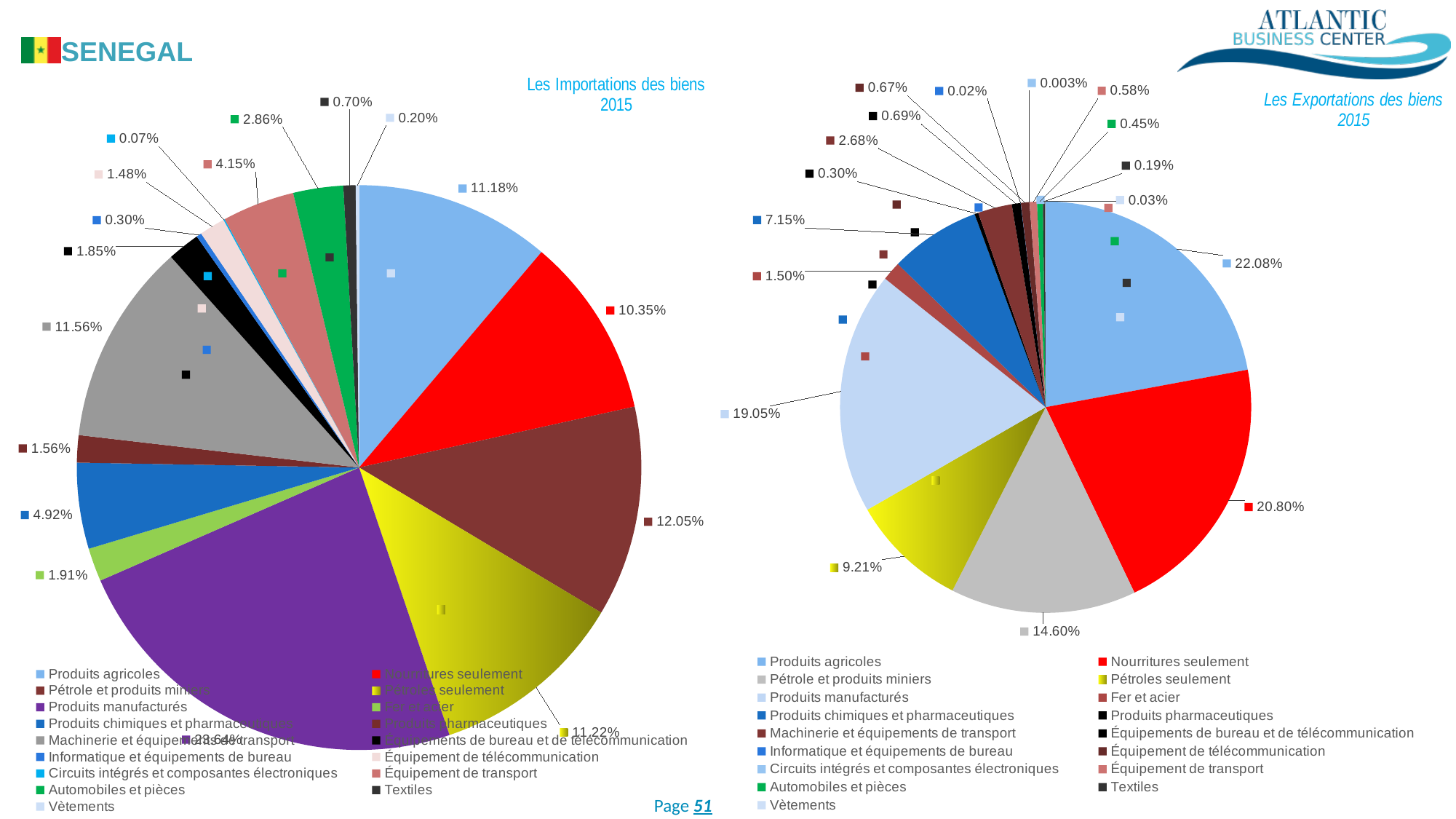
In the 'Les Importations des biens 2015' chart, what is the share for Automobiles et pièces? 2.86% In the 'Les Exportations des biens 2015' chart, what is the difference between the shares of Produits agricoles and Nourritures seulement? 1.28% How many categories does the legend of the 'Les Exportations des biens 2015' chart list? 17 In the 'Les Exportations des biens 2015' chart, what is the share for Produits manufacturés? 19.05% What kind of charts are shown on the slide? Pie charts In the 'Les Exportations des biens 2015' chart, which category has the largest slice? Produits agricoles In the 'Les Exportations des biens 2015' chart, what is the share for Pétrole et produits miniers? 14.60% In the 'Les Importations des biens 2015' chart, what is the share for Nourritures seulement? 10.35% In the 'Les Importations des biens 2015' chart, what is the share for Produits agricoles? 11.18% In the 'Les Importations des biens 2015' chart, which is larger: Pétrole et produits miniers or Produits agricoles? Pétrole et produits miniers In the 'Les Exportations des biens 2015' chart, what is the share for Pétroles seulement? 9.21% In the 'Les Importations des biens 2015' chart, which category has the largest slice? Produits manufacturés